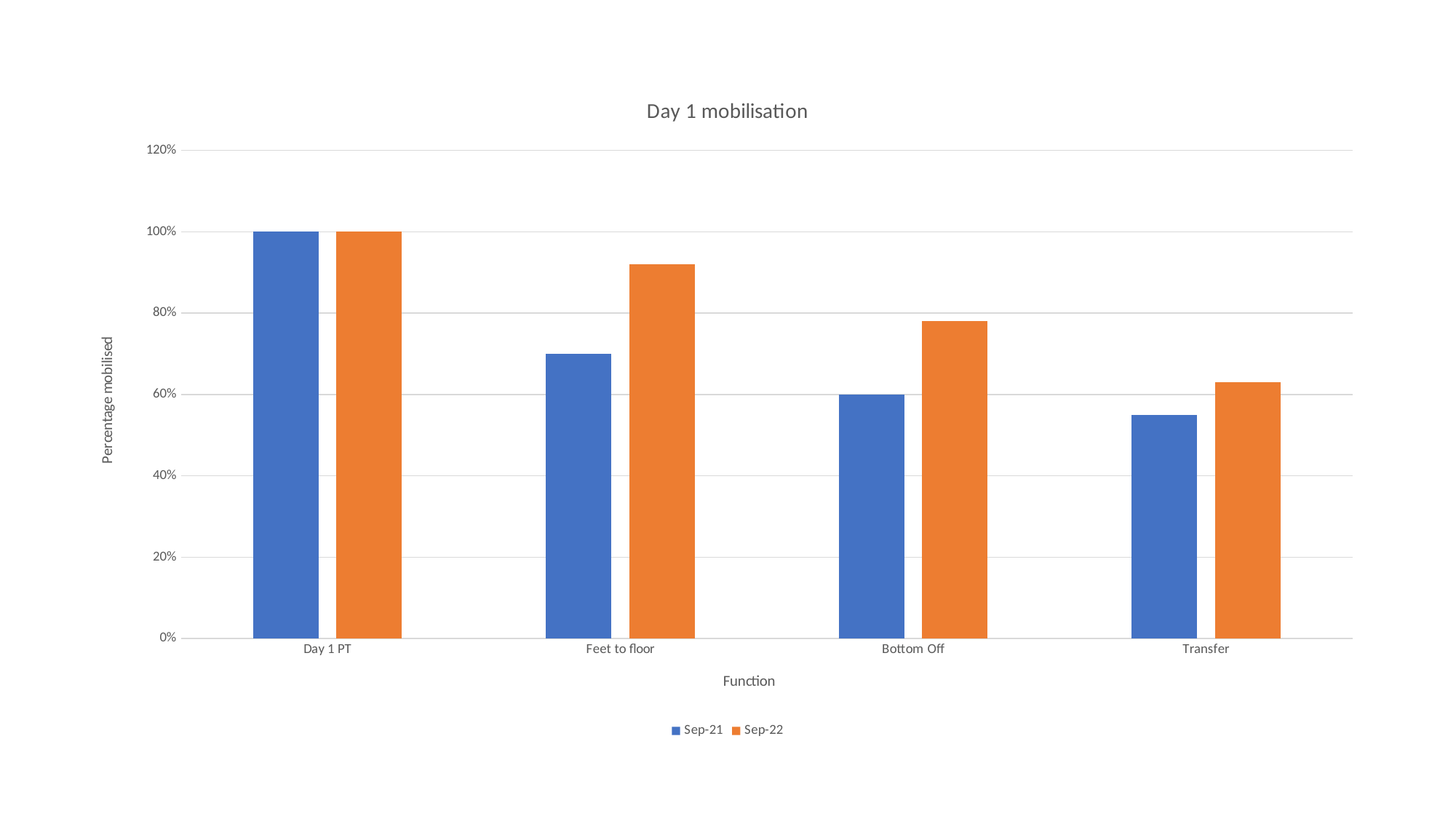
Which category has the lowest Sep-22 value? Transfer What type of chart is shown on the slide? bar chart What is the title of the chart? Day 1 mobilisation What is the Sep-21 value for Bottom Off? 60% How many categories are shown on the x axis? 4 Is the Sep-22 value for Feet to floor greater or less than 80%? greater What is the Sep-21 value for Day 1 PT? 100% How many series does the legend list? 2 Is the Sep-21 value for Transfer greater or less than 60%? less For Feet to floor, which is larger: the Sep-21 value or the Sep-22 value? Sep-22 Do the Sep-22 values rise or fall from Day 1 PT to Transfer along the x axis? fall